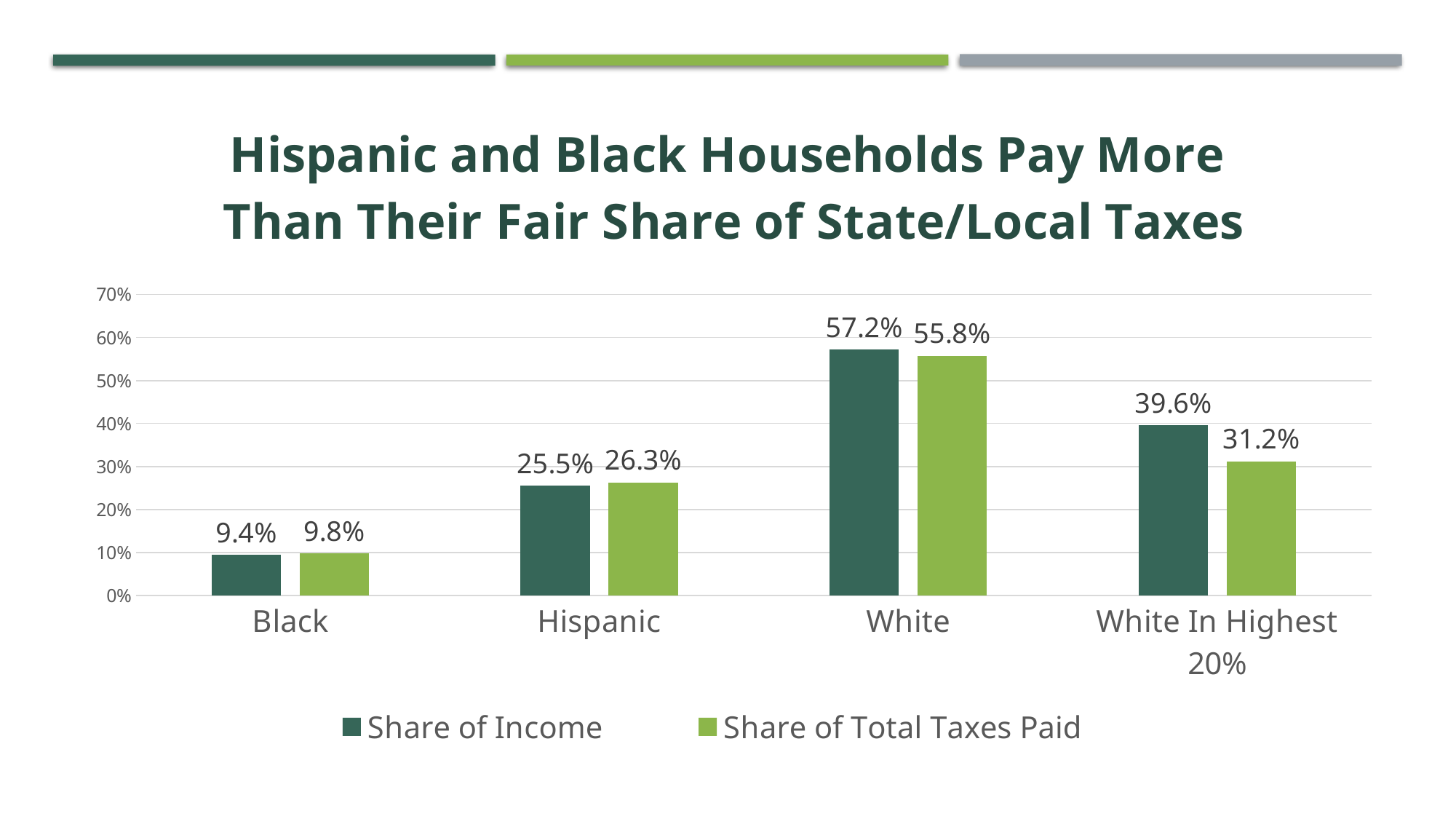
Which category has the highest Share of Income? White What is the difference between Share of Income and Share of Total Taxes Paid for White In Highest 20%? 8.4% What kind of chart is shown on the slide? Bar chart What is the Share of Income for Black households? 9.4% What is the Share of Total Taxes Paid for Hispanic households? 26.3% How many categories are shown on the x axis? 4 Which category has the lowest Share of Total Taxes Paid? Black Is the Share of Income for White households greater or less than 50%? greater How many series does the legend list? 2 What is the Share of Total Taxes Paid for White In Highest 20%? 31.2% For Hispanic households, which is larger: Share of Income or Share of Total Taxes Paid? Share of Total Taxes Paid What is the difference between Share of Income and Share of Total Taxes Paid for White households? 1.4%